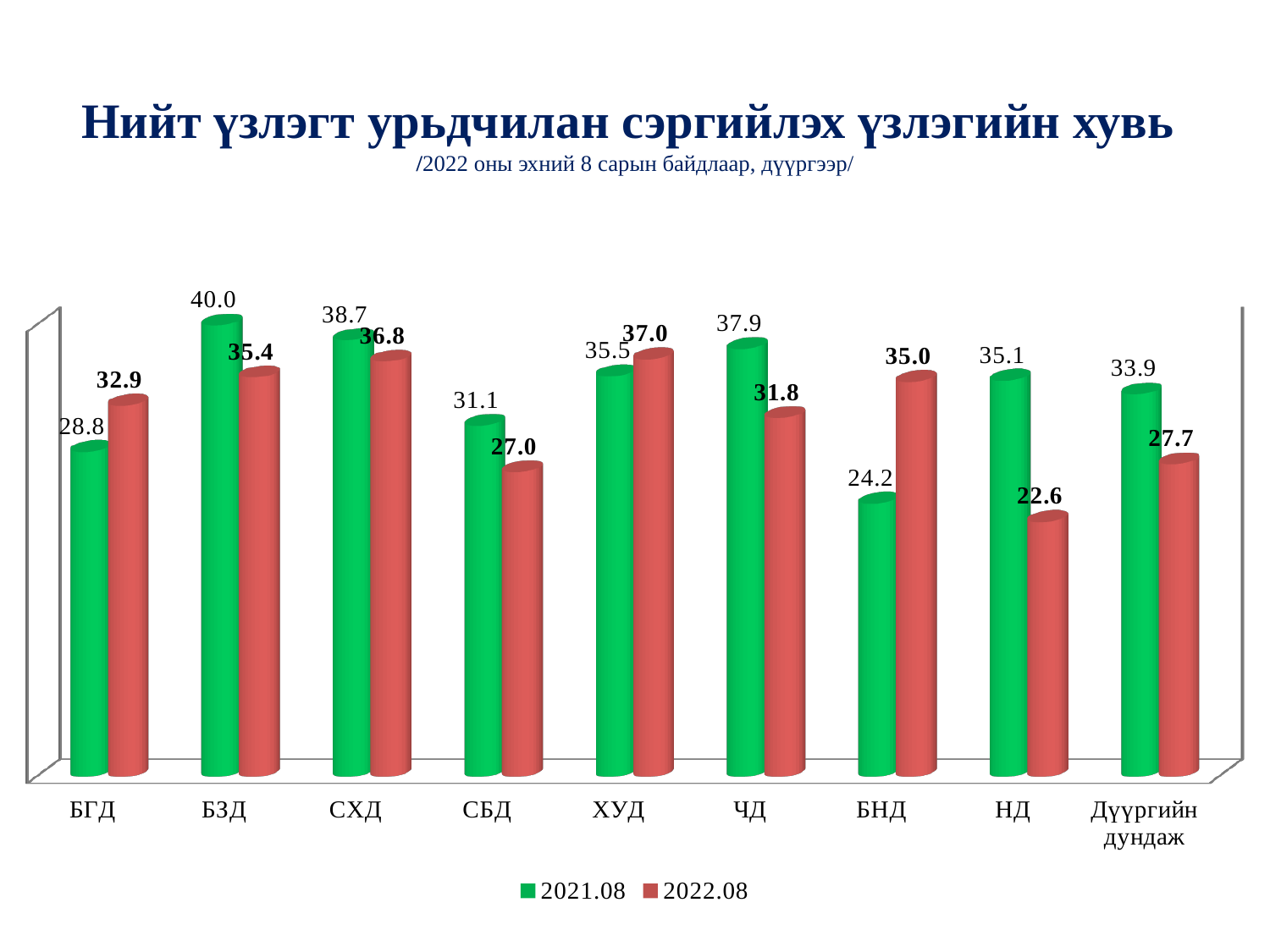
What is the difference between the 2021.08 and 2022.08 values for ЧД? 6.1 What is the 2022.08 value for НД? 22.6 What is the 2022.08 value for Дүүргийн дундаж? 27.7 How many series does the legend list? 2 For БНД, which series has the larger value, 2021.08 or 2022.08? 2022.08 Which category has the highest 2021.08 value? БЗД What is the difference between the 2022.08 and 2021.08 values for БНД? 10.8 Which colour represents the 2022.08 series? Red What is the 2021.08 value for БЗД? 40.0 Which category has the lowest 2022.08 value? НД How many categories are shown on the x axis? 9 What kind of chart is shown on the slide? Bar chart